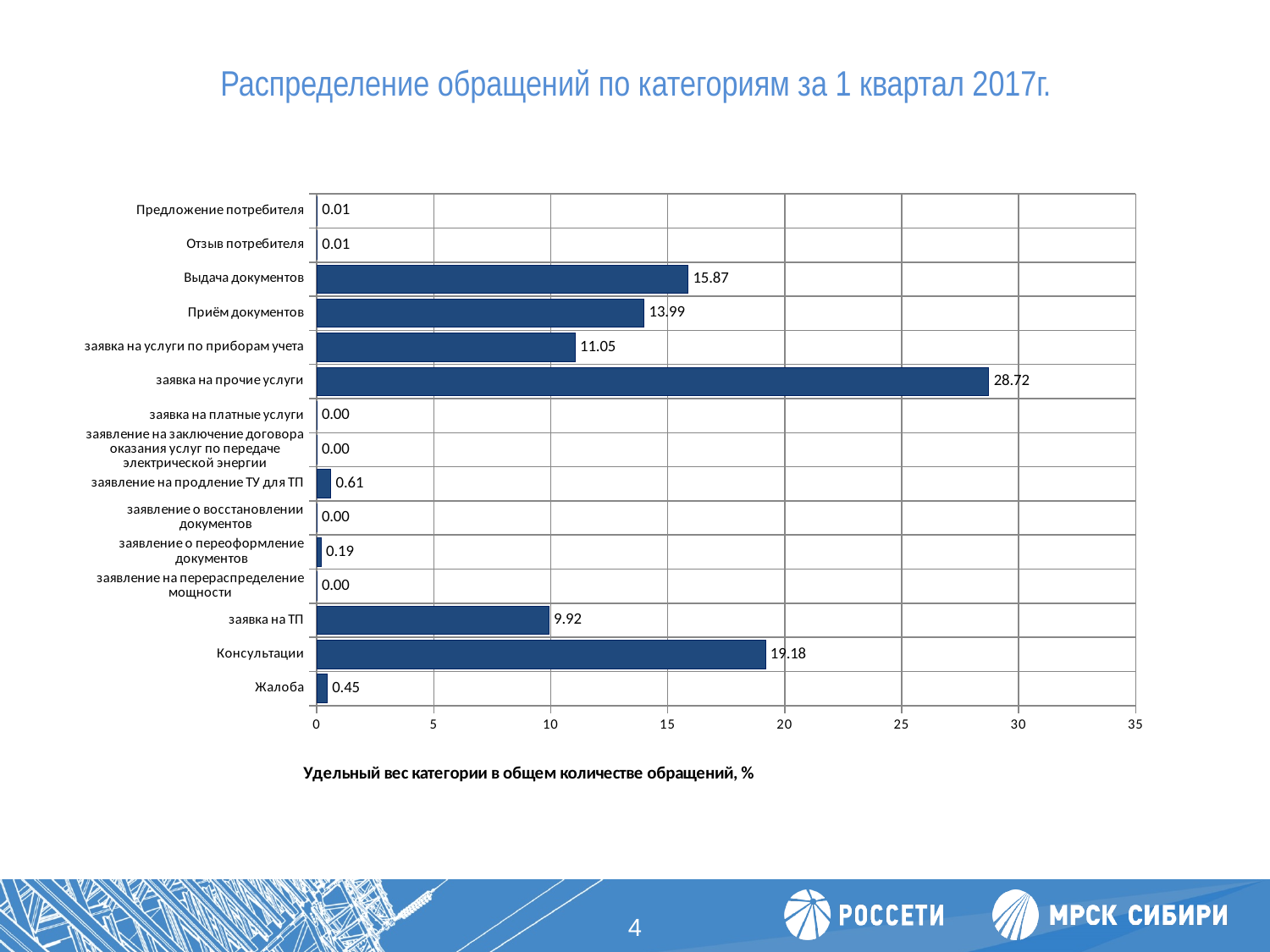
Is the value for "Консультации" greater or less than 15? greater What is the value for "Жалоба"? 0.45 Which is larger, the value for "Приём документов" or the value for "заявка на услуги по приборам учета"? Приём документов What is the value for "Консультации"? 19.18 Which category has the highest value? заявка на прочие услуги What type of chart is shown on the slide? bar chart What is the value for "заявка на ТП"? 9.92 What is the difference between the values for "заявка на прочие услуги" and "Консультации"? 9.54 How many categories are shown on the chart? 15 What is the value for "заявка на прочие услуги"? 28.72 What is the value for "Выдача документов"? 15.87 What is the difference between the values for "Выдача документов" and "Приём документов"? 1.88